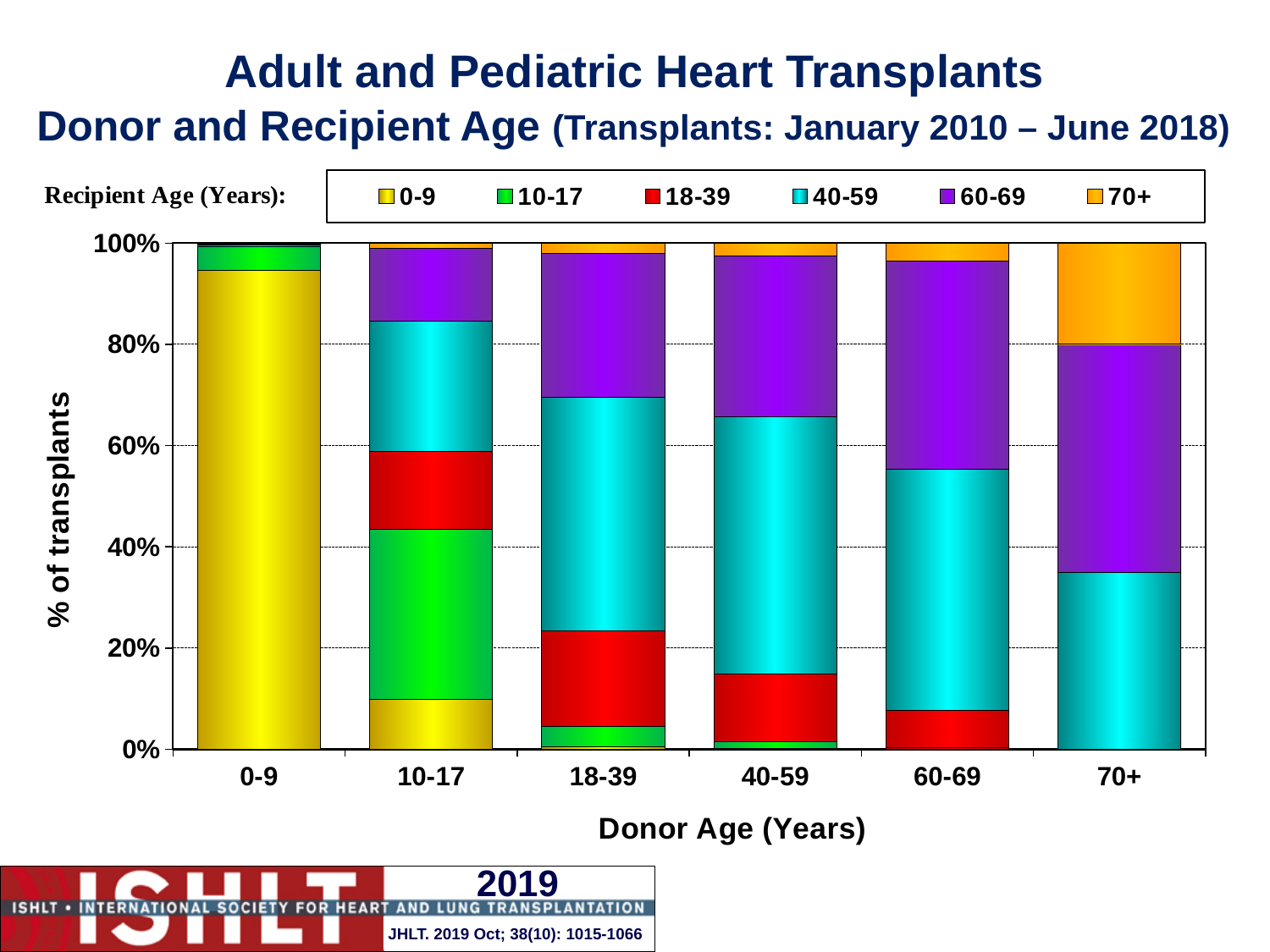
For donor age 70+, which recipient age group has the larger share, 40-59 or 60-69? 60-69 What is the title of the y axis? % of transplants Is the share of 70+ recipients for donor age 70+ greater or less than 40%? less What is the title of the x axis? Donor Age (Years) Which donor age group has the largest share of 70+ recipients? 70+ Which donor age group has the largest share of 10-17 recipients? 10-17 Is the share of 40-59 recipients for donor age 40-59 greater or less than 40%? greater How many recipient age groups does the legend list? 6 Is the share of 0-9 recipients for donor age 0-9 greater or less than 80%? greater How many donor age categories are shown on the x axis? 6 For donor age 18-39, which recipient age group has the larger share, 18-39 or 40-59? 40-59 What kind of chart is shown on the slide? Stacked bar chart